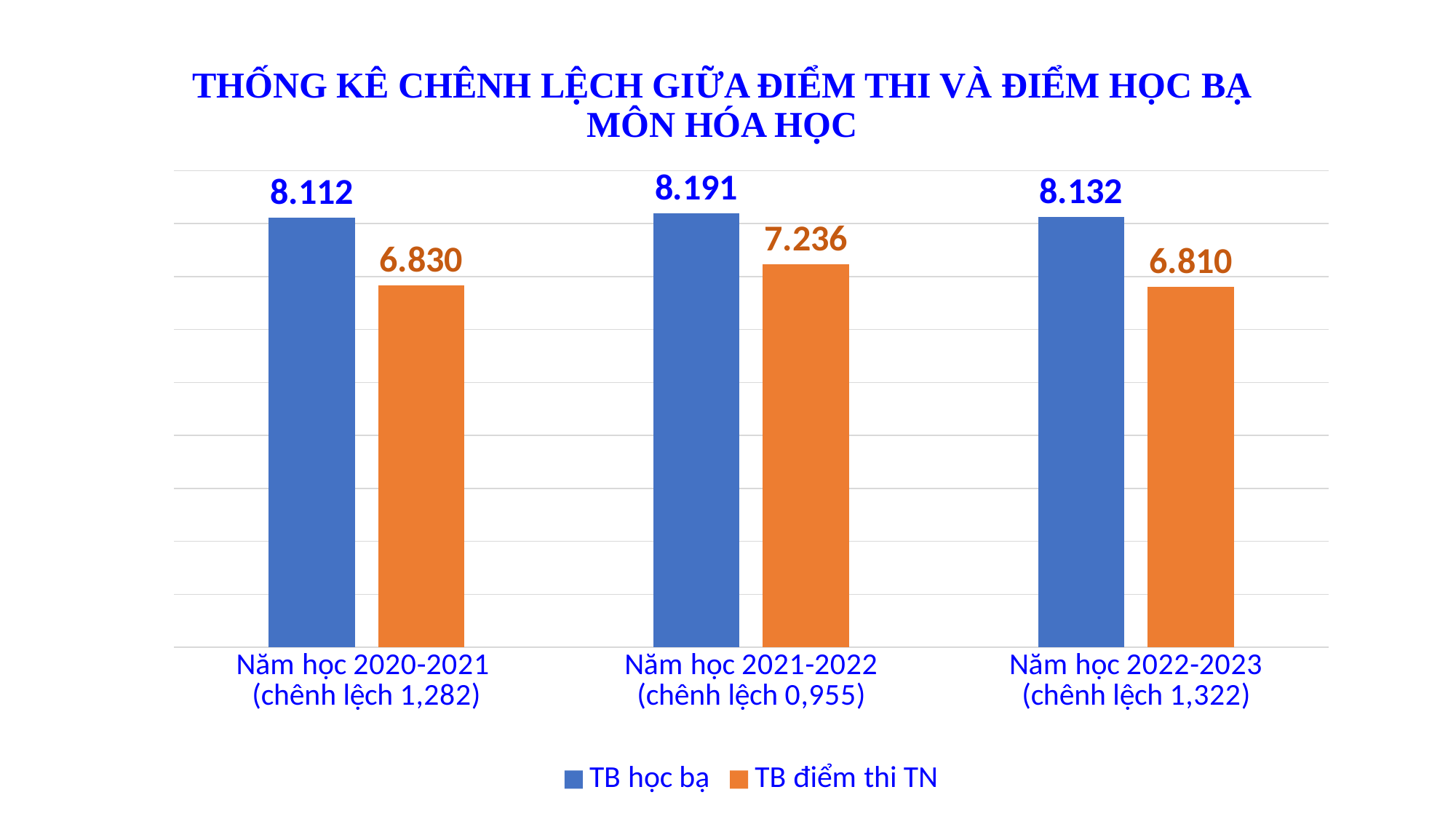
How many school years (categories) are shown on the x axis? 3 What is the difference between TB học bạ and TB điểm thi TN for Năm học 2022-2023? 1.322 What is the difference between TB học bạ and TB điểm thi TN for Năm học 2021-2022? 0.955 What is the value of TB học bạ for Năm học 2020-2021? 8.112 In which school year is TB điểm thi TN the lowest? Năm học 2022-2023 What is the value of TB điểm thi TN for Năm học 2022-2023? 6.810 What is the value of TB điểm thi TN for Năm học 2021-2022? 7.236 Which colour represents TB điểm thi TN in the chart? Orange How many series does the legend list? 2 Which is larger: TB điểm thi TN for Năm học 2020-2021 or for Năm học 2022-2023? Năm học 2020-2021 What type of chart is shown on the slide? Bar chart In which school year is TB học bạ the highest? Năm học 2021-2022